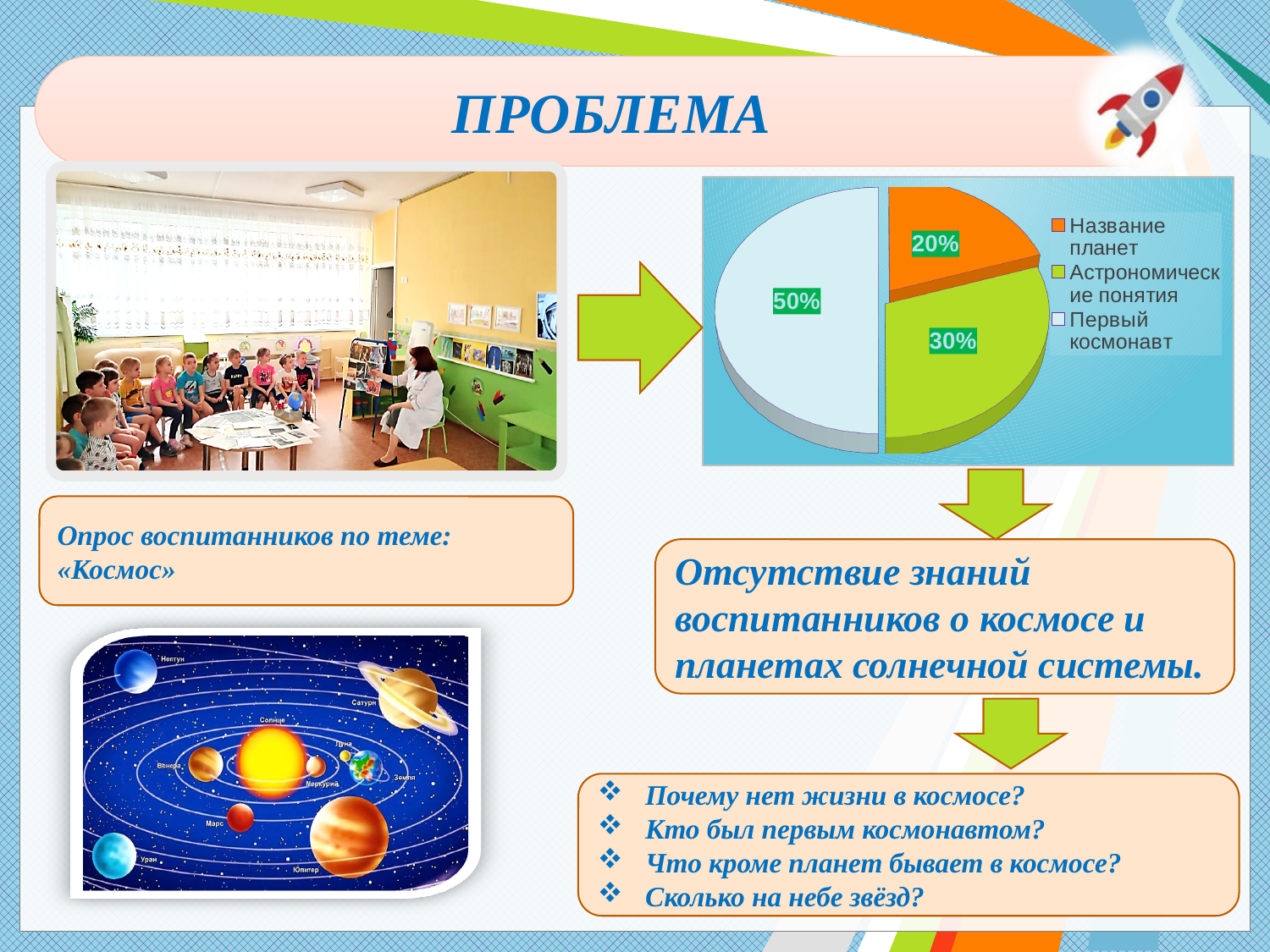
How many slices does the pie chart have? 3 What colour is the slice for "Название планет"? orange What percentage does the slice for "Астрономические понятия" show? 30% What is the difference in percentage points between "Астрономические понятия" and "Название планет"? 10 Which is larger: the slice for "Астрономические понятия" or the slice for "Название планет"? Астрономические понятия How many entries does the chart legend list? 3 What kind of chart is shown on the slide? pie chart What is the difference in percentage points between "Первый космонавт" and "Название планет"? 30 What percentage does the slice for "Первый космонавт" show? 50% Which category has the smallest slice of the pie? Название планет What percentage does the slice for "Название планет" show? 20% Which category has the largest slice of the pie? Первый космонавт